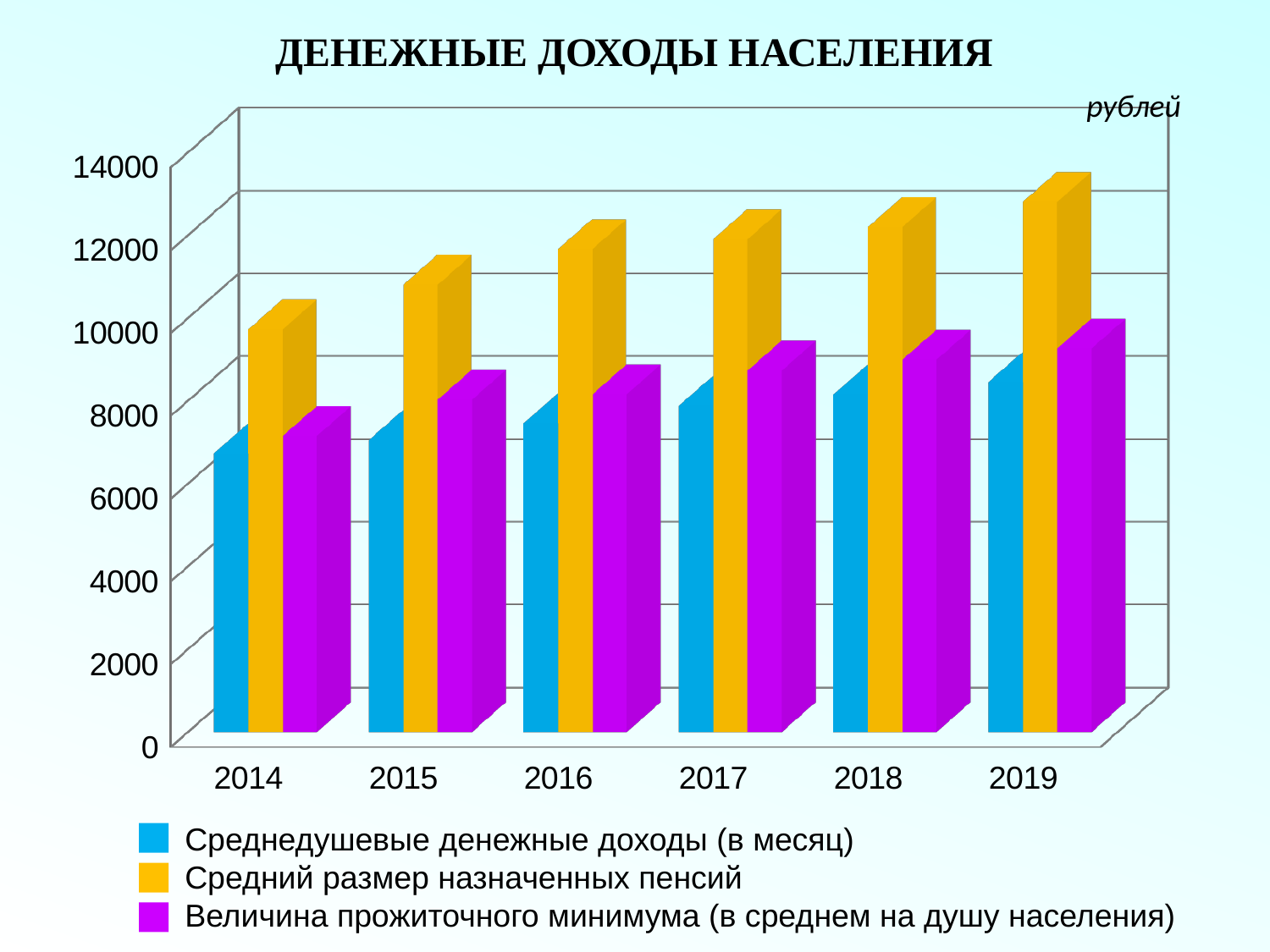
Which year has the highest value for Средний размер назначенных пенсий? 2019 What is the title of the chart? ДЕНЕЖНЫЕ ДОХОДЫ НАСЕЛЕНИЯ Is the value for Величина прожиточного минимума in 2019 greater or less than 8000? greater Is the value for Средний размер назначенных пенсий in 2014 greater or less than 8000? greater What type of chart is shown on the slide? bar chart Is the value for Средний размер назначенных пенсий in 2019 greater or less than 12000? greater How many series does the legend list? 3 In 2014, which is larger: Средний размер назначенных пенсий or Среднедушевые денежные доходы (в месяц)? Средний размер назначенных пенсий Do the values for Средний размер назначенных пенсий rise or fall from 2014 to 2019? rise Which year has the lowest value for Среднедушевые денежные доходы (в месяц)? 2014 How many years are shown on the x axis? 6